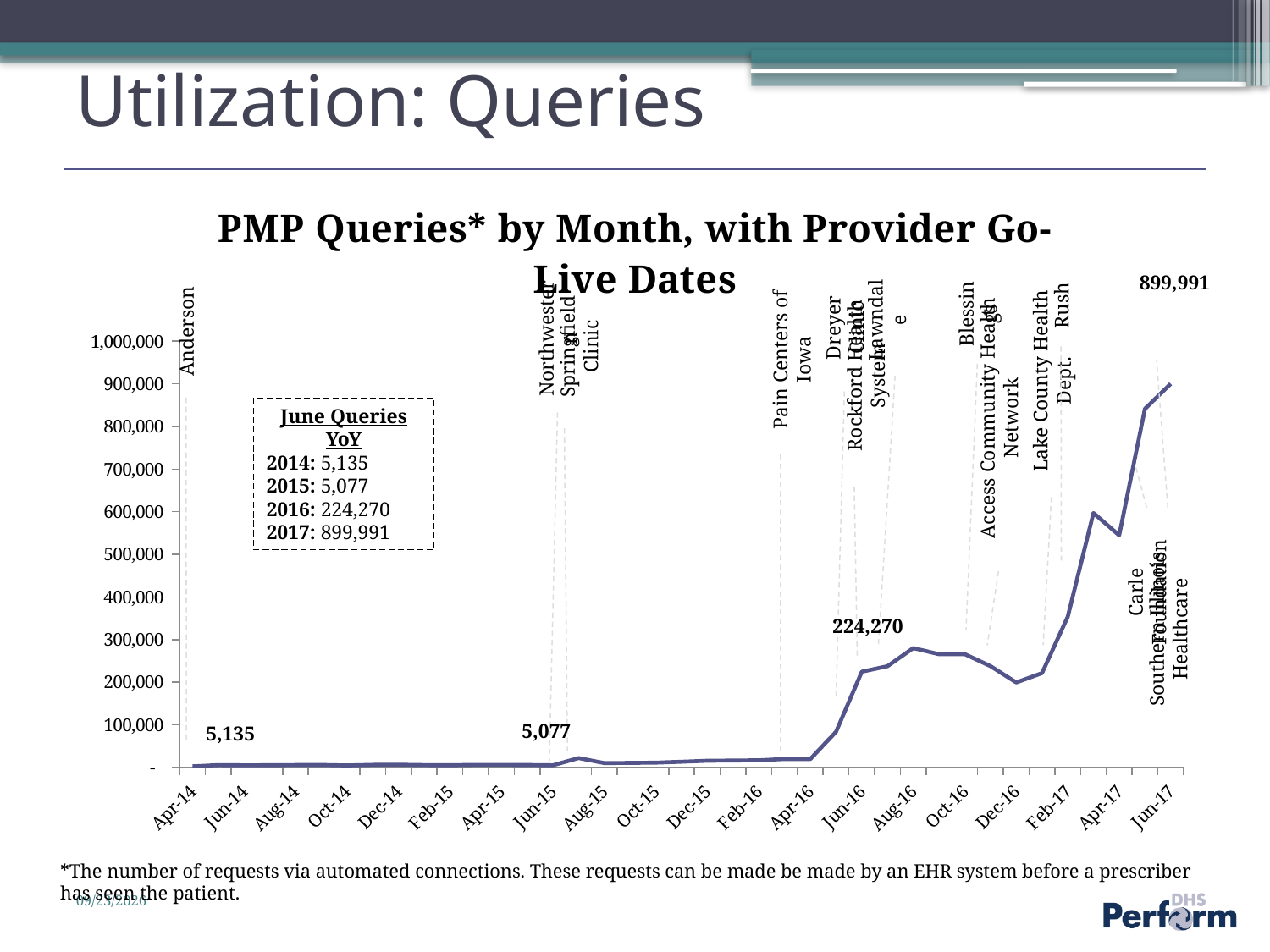
What is the number of PMP queries shown for Jun-15? 5,077 Is the value for Dec-16 greater or less than 400,000? less Is the value for Apr-17 greater or less than 700,000? less Which labeled month has the highest number of PMP queries? Jun-17 What is the difference between the June 2014 and June 2015 query counts? 58 Which is larger, the query count for Jun-15 or for Jun-16? Jun-16 What is the number of PMP queries shown for Jun-16? 224,270 What is the difference between the June 2017 and June 2016 query counts? 675,721 What kind of chart is used to show PMP queries by month? Line chart What is the number of PMP queries shown for Jun-14? 5,135 What is the number of PMP queries shown for Jun-17? 899,991 Do PMP queries generally rise or fall from Apr-14 to Jun-17? Rise